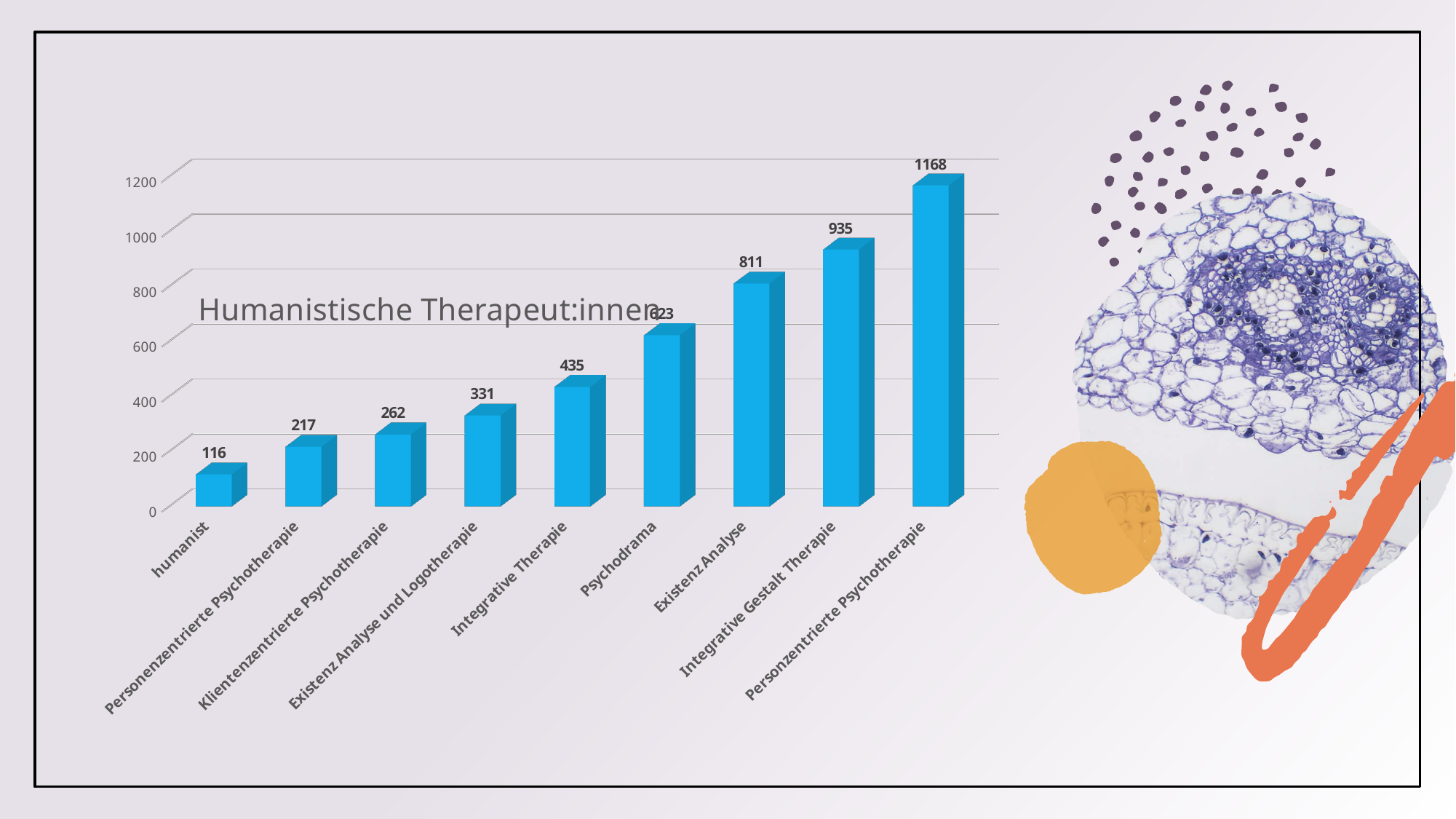
What is the value for Integrative Gestalt Therapie? 935 How many categories are shown in the chart? 9 What is the value for Integrative Therapie? 435 Which category has the highest value? Personzentrierte Psychotherapie What is the difference between the values for Klientenzentrierte Psychotherapie and Personenzentrierte Psychotherapie? 45 What is the difference between the values for Personzentrierte Psychotherapie and Integrative Gestalt Therapie? 233 What kind of chart is shown on the slide? bar chart What is the value for Existenz Analyse und Logotherapie? 331 Which category has the lowest value? humanist What is the title of the chart? Humanistische Therapeut:innen Is the value for Psychodrama greater or less than 400? greater Which is larger, the value for Existenz Analyse or the value for Integrative Therapie? Existenz Analyse